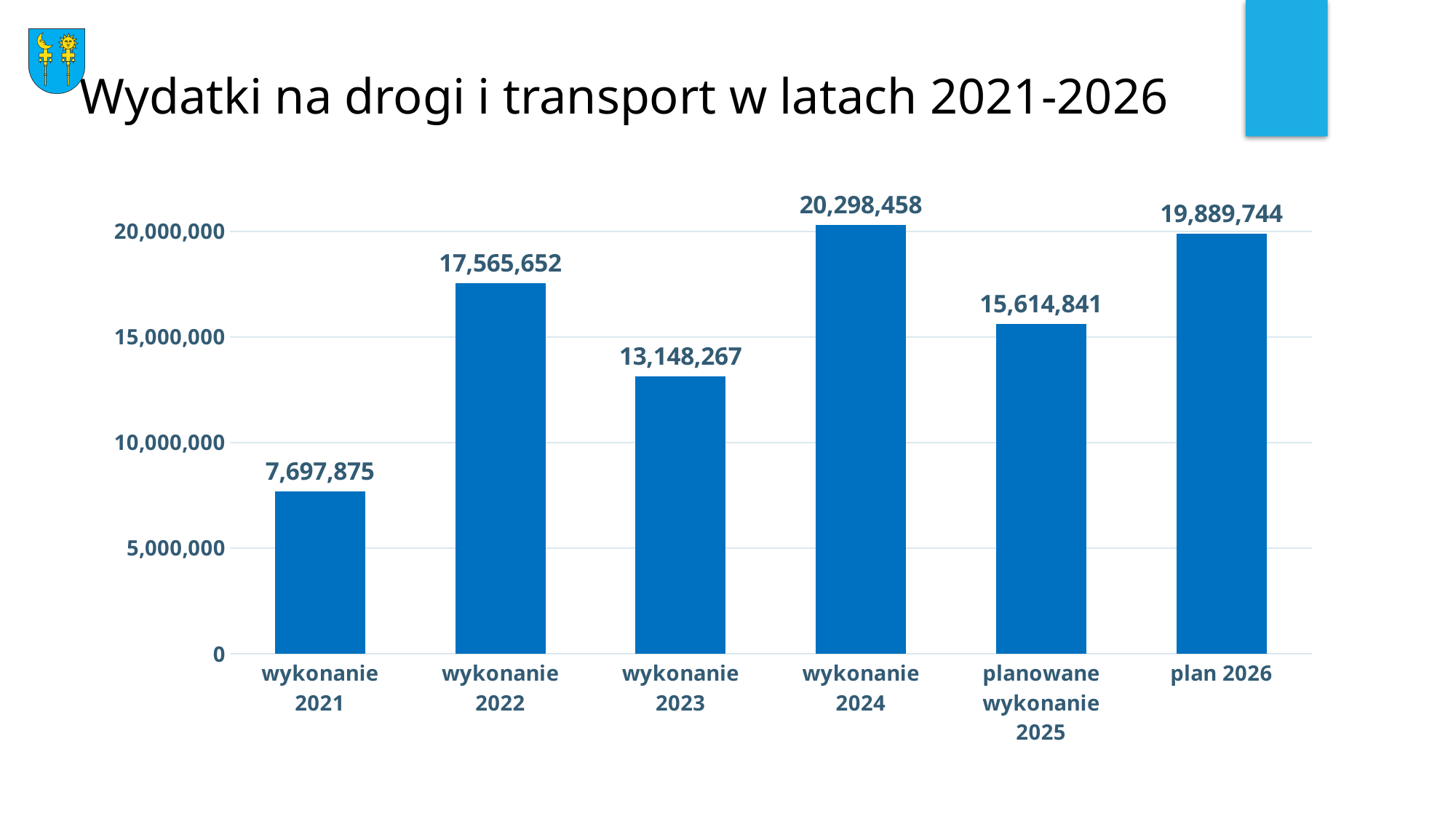
Is the value for wykonanie 2023 greater or less than 15,000,000? less Which category has the highest value? wykonanie 2024 What is the value for planowane wykonanie 2025? 15,614,841 What is the value for wykonanie 2023? 13,148,267 What is the value for wykonanie 2021? 7,697,875 What is the difference between wykonanie 2024 and wykonanie 2021? 12,600,583 Which is larger, wykonanie 2022 or planowane wykonanie 2025? wykonanie 2022 What is the value for plan 2026? 19,889,744 What is the difference between wykonanie 2022 and wykonanie 2023? 4,417,385 What type of chart is shown on the slide? bar chart How many categories are shown on the chart? 6 Which category has the lowest value? wykonanie 2021